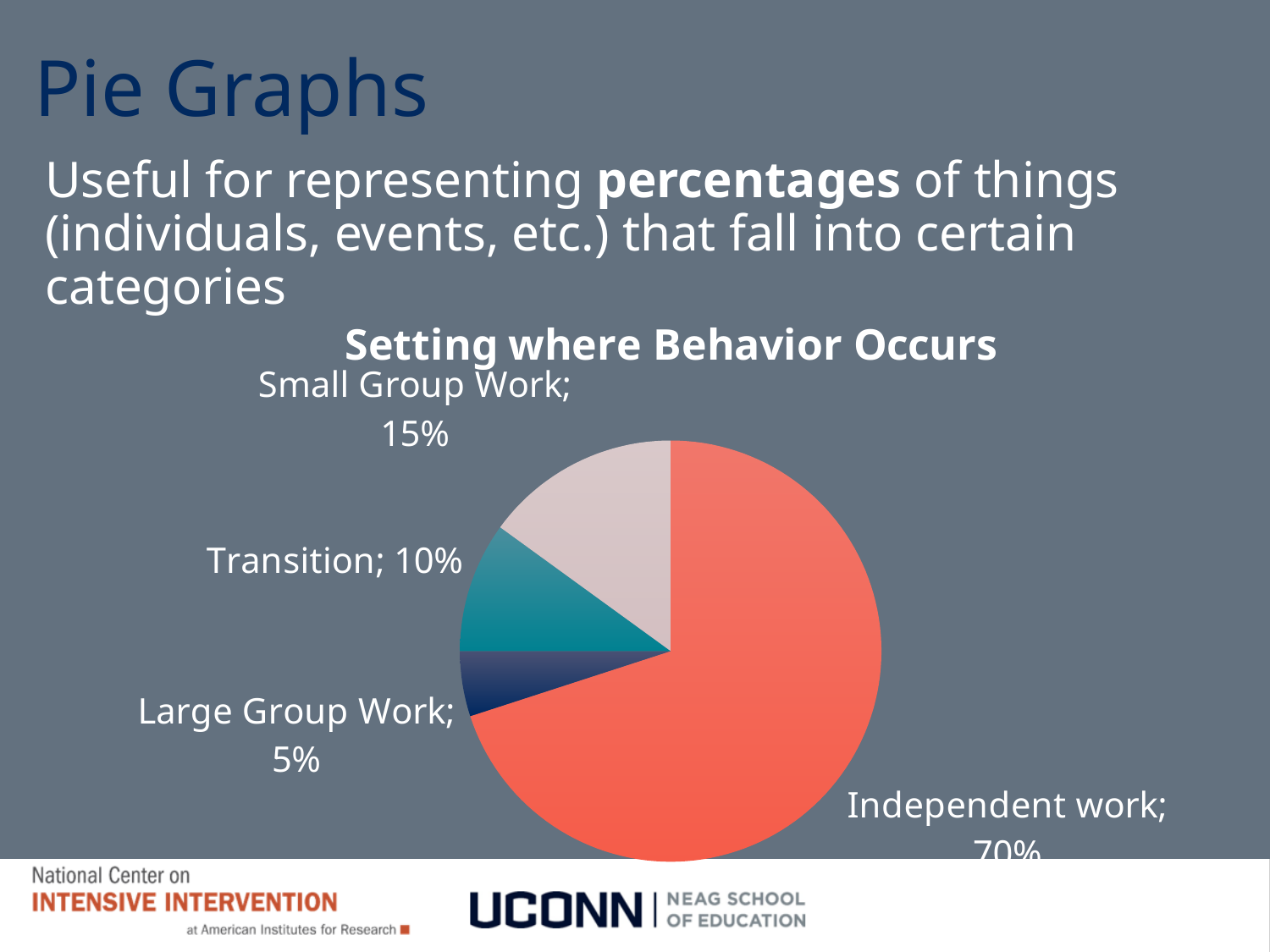
What is the title of the pie chart? Setting where Behavior Occurs Which is larger, the share for Transition or the share for Large Group Work? Transition Which setting has the smallest share of the pie? Large Group Work What kind of chart is shown on the slide? pie chart What is the difference in percentage points between Small Group Work and Transition? 5 What percentage of the pie is Large Group Work? 5% Which setting has the largest share of the pie? Independent work What percentage of the pie is Transition? 10% What is the difference in percentage points between Independent work and Small Group Work? 55 What percentage of the pie is Small Group Work? 15% How many slices does the pie chart have? 4 What percentage of the pie is Independent work? 70%